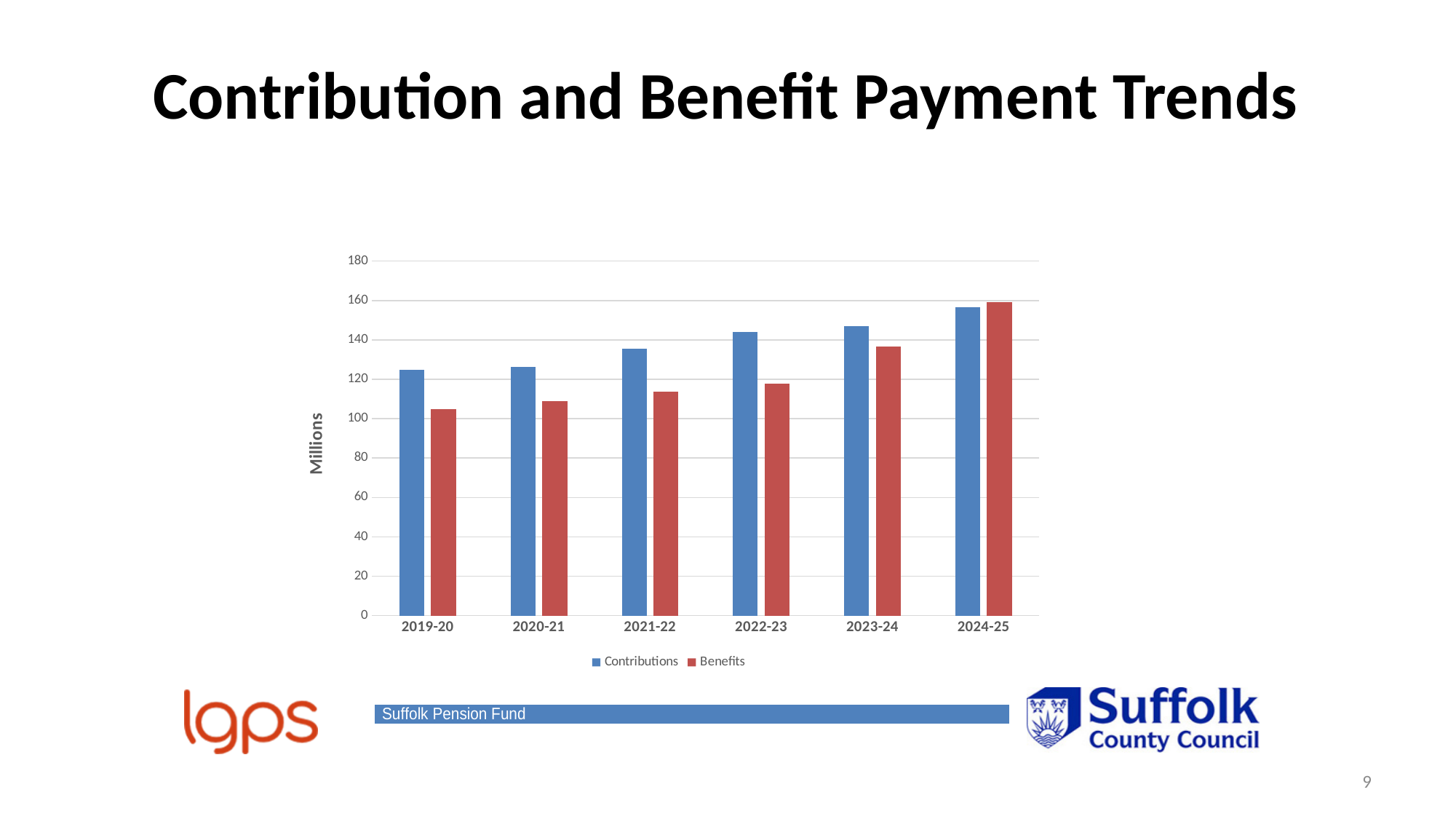
In 2021-22, which is larger, Contributions or Benefits? Contributions Which year has the highest Benefits value? 2024-25 How many financial years are shown on the x axis? 6 Is the Contributions value for 2022-23 greater or less than 140? greater In 2019-20, which is larger, Contributions or Benefits? Contributions Do the Contributions values rise or fall from 2019-20 to 2024-25? rise What kind of chart is shown on the slide? bar chart Which year has the highest Contributions value? 2024-25 What is the label on the vertical axis? Millions Is the Benefits value for 2021-22 greater or less than 120? less Is the Contributions value for 2019-20 greater or less than 120? greater How many series does the legend list? 2